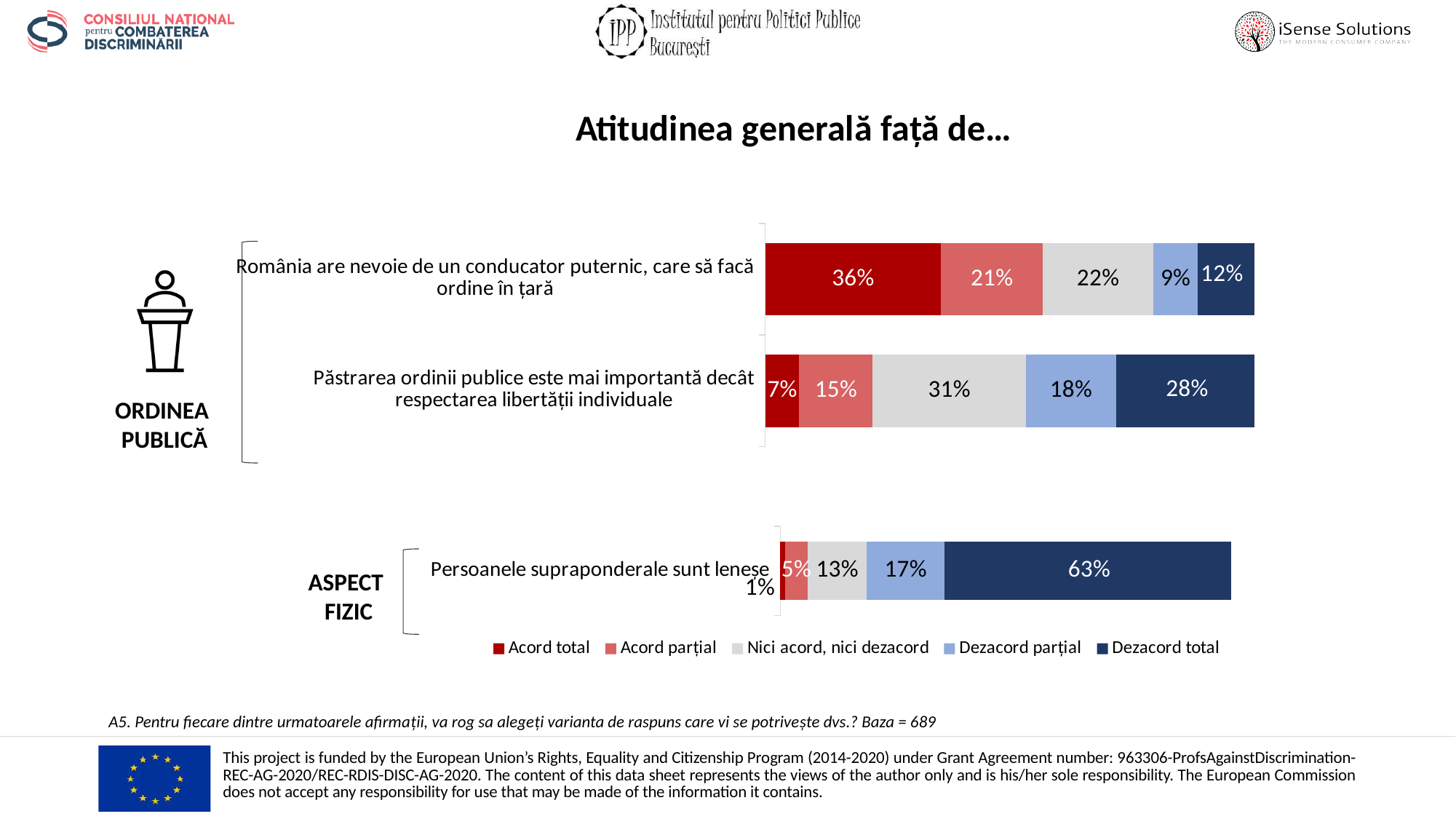
What is the 'Nici acord, nici dezacord' value for the statement 'Păstrarea ordinii publice este mai importantă decât respectarea libertății individuale'? 31% What type of chart is shown on the slide? Stacked bar chart What is the combined 'Acord total' and 'Acord parțial' value for the statement 'România are nevoie de un conducator puternic, care să facă ordine în țară'? 57% Which legend entry is shown in the darkest red colour? Acord total Which statement has the lowest 'Dezacord total' value? România are nevoie de un conducator puternic, care să facă ordine în țară Which statement has the highest 'Acord total' value? România are nevoie de un conducator puternic, care să facă ordine în țară How many series does the legend list? 5 What is the difference between the 'Dezacord total' values for 'Persoanele supraponderale sunt leneșe' and 'Păstrarea ordinii publice este mai importantă decât respectarea libertății individuale'? 35% What is the 'Acord total' value for the statement 'România are nevoie de un conducator puternic, care să facă ordine în țară'? 36% Which is larger: the 'Dezacord parțial' value for 'Păstrarea ordinii publice este mai importantă decât respectarea libertății individuale' or for 'România are nevoie de un conducator puternic, care să facă ordine în țară'? Păstrarea ordinii publice este mai importantă decât respectarea libertății individuale How many statements (bars) are plotted in the chart? 3 What is the 'Dezacord total' value for the statement 'Persoanele supraponderale sunt leneșe'? 63%